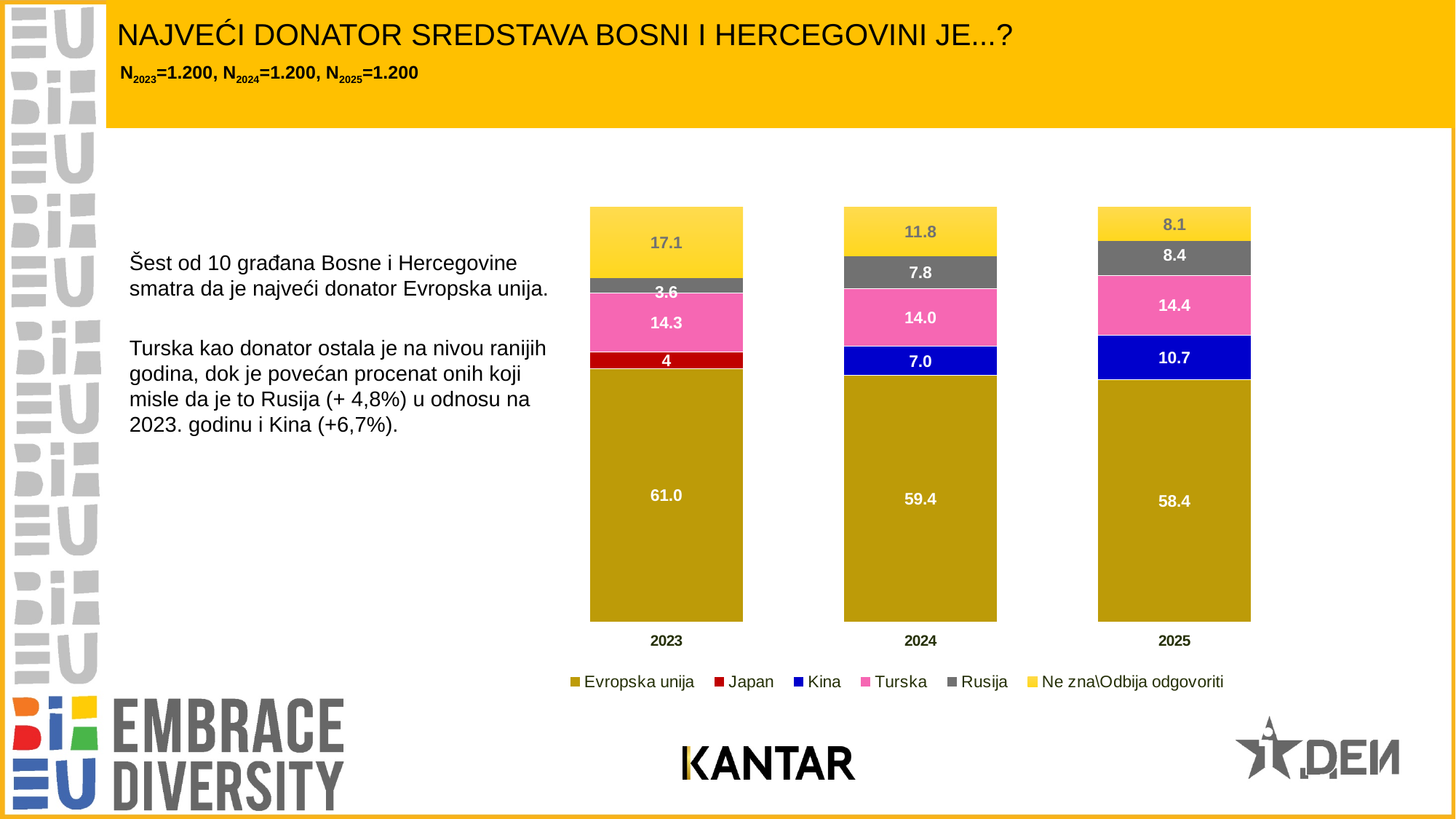
What is the value for Ne zna\Odbija odgovoriti in 2025? 8.1 How many series does the legend list? 6 What kind of chart is shown on the slide? stacked bar chart Which is larger in 2025, the value for Rusija or the value for Kina? Kina Does the value for Evropska unija rise or fall from 2023 to 2025? fall What is the value for Rusija in 2024? 7.8 What is the value for Turska in 2025? 14.4 What is the difference between the Kina values in 2025 and 2024? 3.7 In which year is the value for Ne zna\Odbija odgovoriti the lowest? 2025 In which year is the value for Evropska unija the highest? 2023 How many years (bars) are shown on the x axis? 3 What is the value for Evropska unija in 2023? 61.0